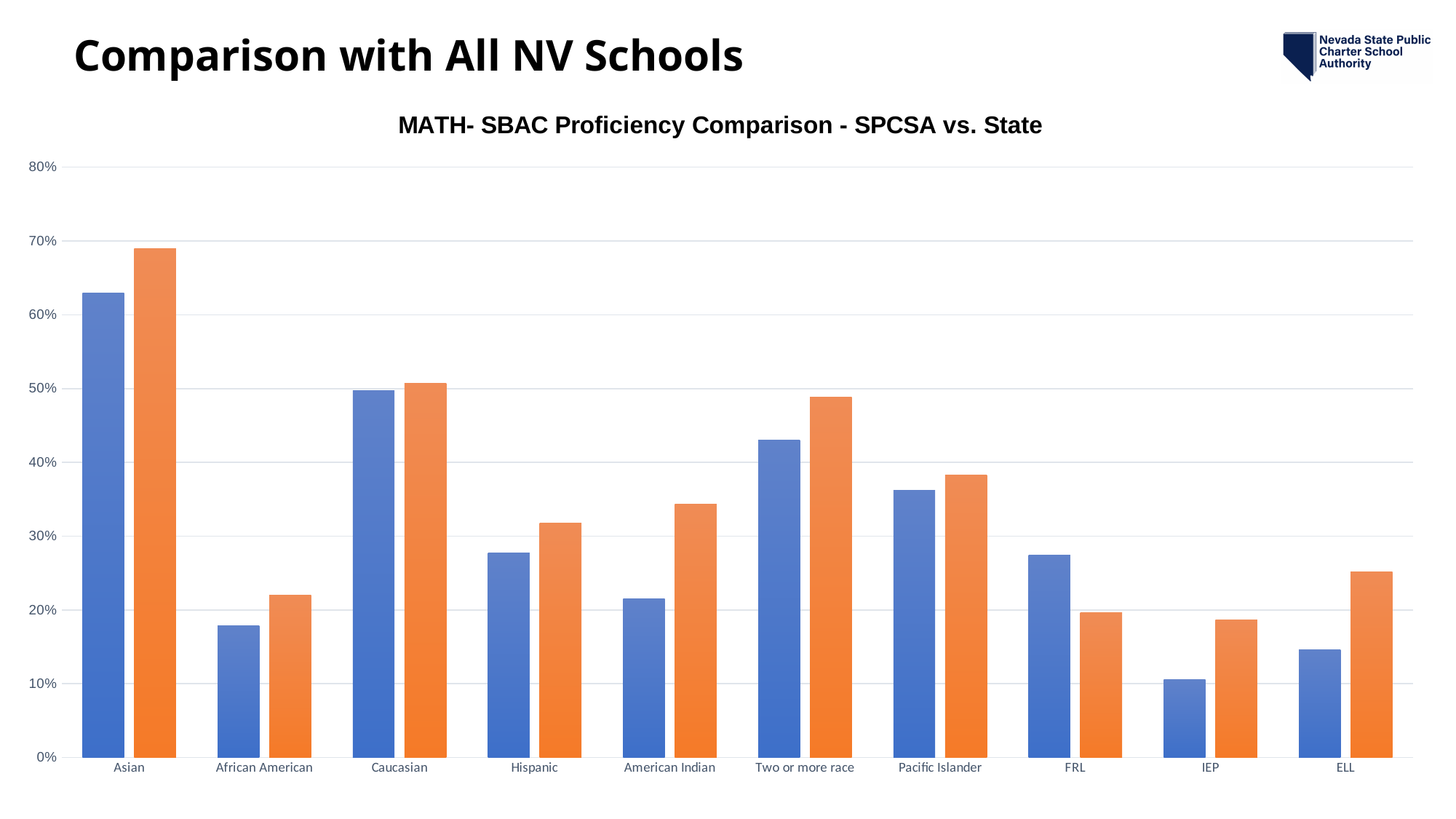
Which category has the shortest blue bar? IEP Which category has the tallest orange bar? Asian Is the value of the blue bar for Asian greater or less than 60%? greater Is the value of the orange bar for Hispanic greater or less than 30%? greater For FRL, which bar is taller, the blue bar or the orange bar? the blue bar Which category has the tallest blue bar? Asian For Asian, which bar is taller, the blue bar or the orange bar? the orange bar Is the value of the blue bar for African American greater or less than 20%? less How many categories are shown along the x axis of the chart? 10 What is the title of the chart? MATH- SBAC Proficiency Comparison - SPCSA vs. State What kind of chart is shown on the slide? bar chart